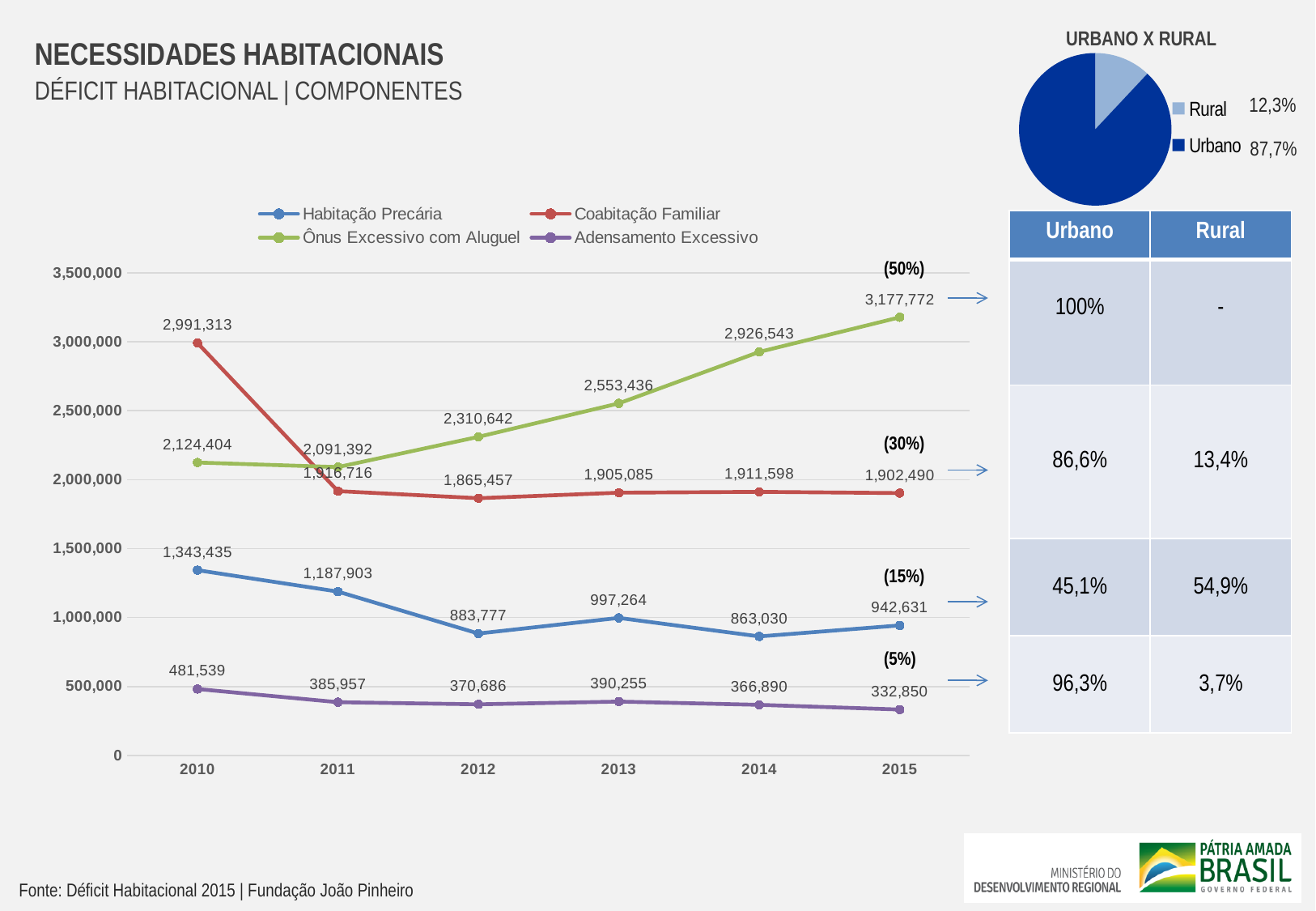
In the line chart, which is larger: Habitação Precária in 2013 or in 2014? 2013 In the URBANO X RURAL pie chart, what share is Rural? 12,3% In the line chart, what is the difference between the Ônus Excessivo com Aluguel values in 2015 and 2010? 1,053,368 In the line chart, which series has the lowest value in 2010? Adensamento Excessivo In the line chart, does Ônus Excessivo com Aluguel rise or fall from 2011 to 2015? rise In the line chart, how many years are shown on the x axis? 6 In the line chart, which series has the highest value in 2015? Ônus Excessivo com Aluguel In the line chart, what is the value of Adensamento Excessivo in 2013? 390,255 What kind of chart is the URBANO X RURAL chart? pie chart In the line chart, how many series does the legend list? 4 In the line chart, what is the value of Coabitação Familiar in 2010? 2,991,313 In the line chart, what is the value of Ônus Excessivo com Aluguel in 2015? 3,177,772